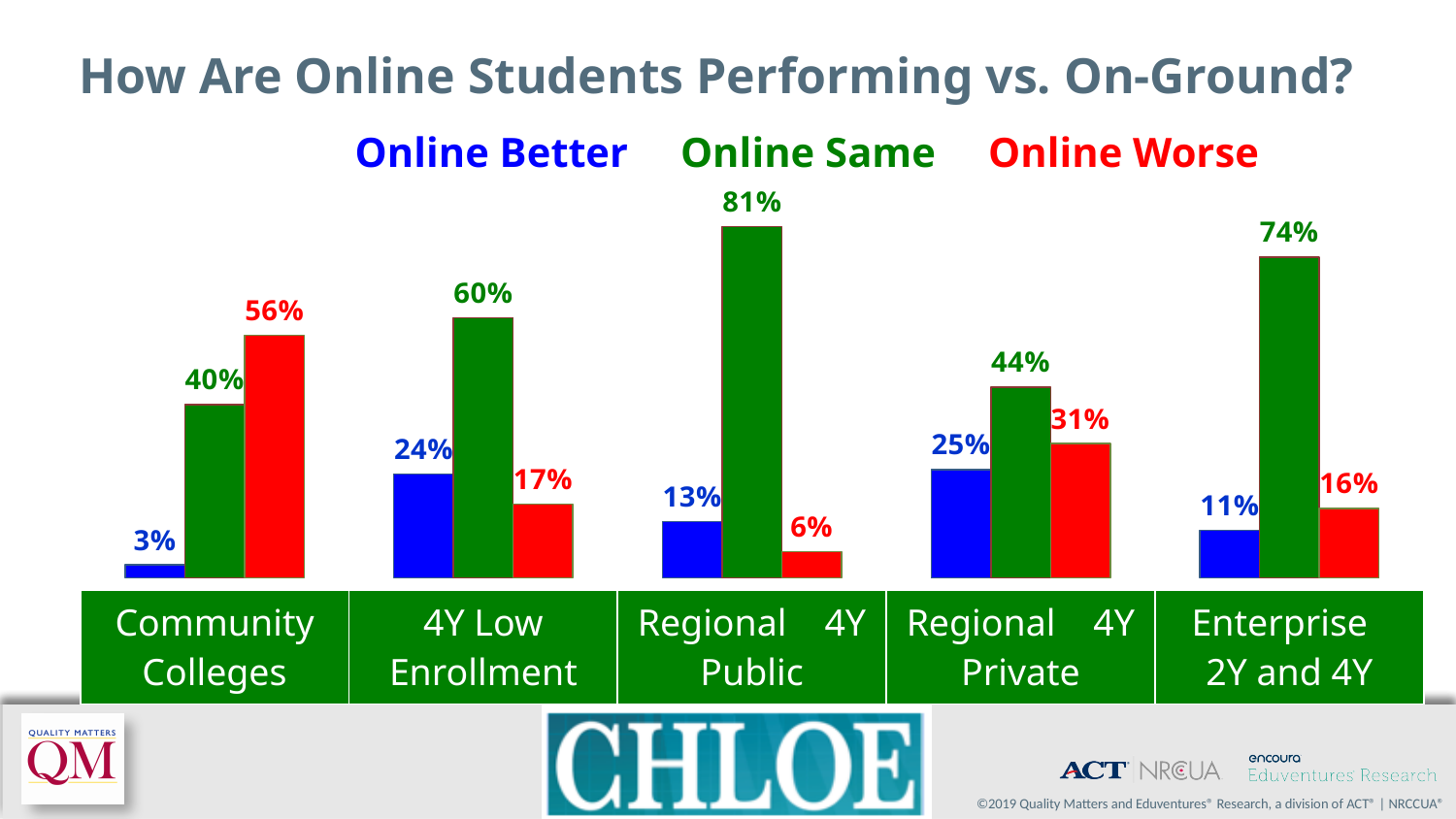
Which institution category has the lowest 'Online Better' value? Community Colleges Which institution category has the highest 'Online Same' value? Regional 4Y Public What kind of chart is shown on the slide? Bar chart What is the title of the slide? How Are Online Students Performing vs. On-Ground? What is the 'Online Same' value for Regional 4Y Public? 81% How many series does the legend list? 3 What percentage of Community Colleges report online students performing worse than on-ground? 56% What colour represents the 'Online Worse' series? Red What is the 'Online Better' value for Enterprise 2Y and 4Y? 11% How many institution categories are shown on the x axis? 5 Which is larger for Regional 4Y Private: the 'Online Better' value or the 'Online Worse' value? Online Worse What is the difference between the 'Online Same' and 'Online Worse' values for 4Y Low Enrollment? 43%